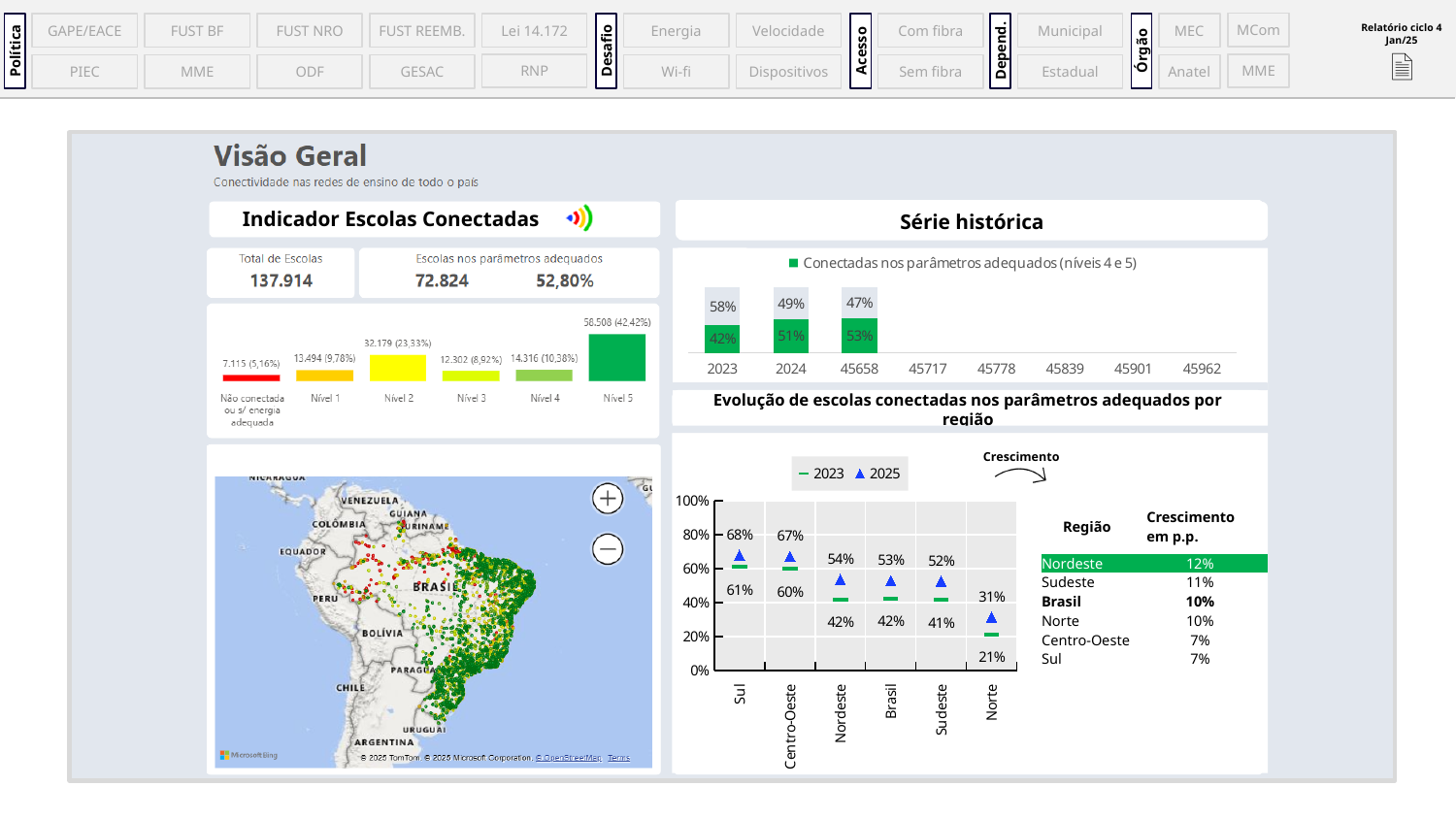
In the 'Evolução de escolas conectadas nos parâmetros adequados por região' chart, what is the difference between the 2025 and 2023 values for Nordeste? 12% In the 'Indicador Escolas Conectadas' chart, how many categories are shown on the x axis? 6 In the 'Série histórica' chart, what percentage is shown in the green segment for 2024? 51% In the 'Série histórica' chart, what percentage is shown in the grey segment for 2023? 58% In the 'Indicador Escolas Conectadas' chart, what is the value shown for Nível 2? 32.179 (23,33%) In the 'Indicador Escolas Conectadas' chart, which category has the lowest number of schools? Não conectada ou s/ energia adequada In the 'Indicador Escolas Conectadas' chart, what is the value shown for Nível 5? 58.508 (42,42%) In the 'Série histórica' chart, what is the legend entry? Conectadas nos parâmetros adequados (níveis 4 e 5) In the 'Evolução de escolas conectadas nos parâmetros adequados por região' chart, what is the 2023 value for Norte? 21% In the 'Evolução de escolas conectadas nos parâmetros adequados por região' chart, what is the 2025 value for Sul? 68% In the 'Evolução de escolas conectadas nos parâmetros adequados por região' chart, how many series does the legend list? 2 In the 'Indicador Escolas Conectadas' chart, which level has the highest number of schools? Nível 5